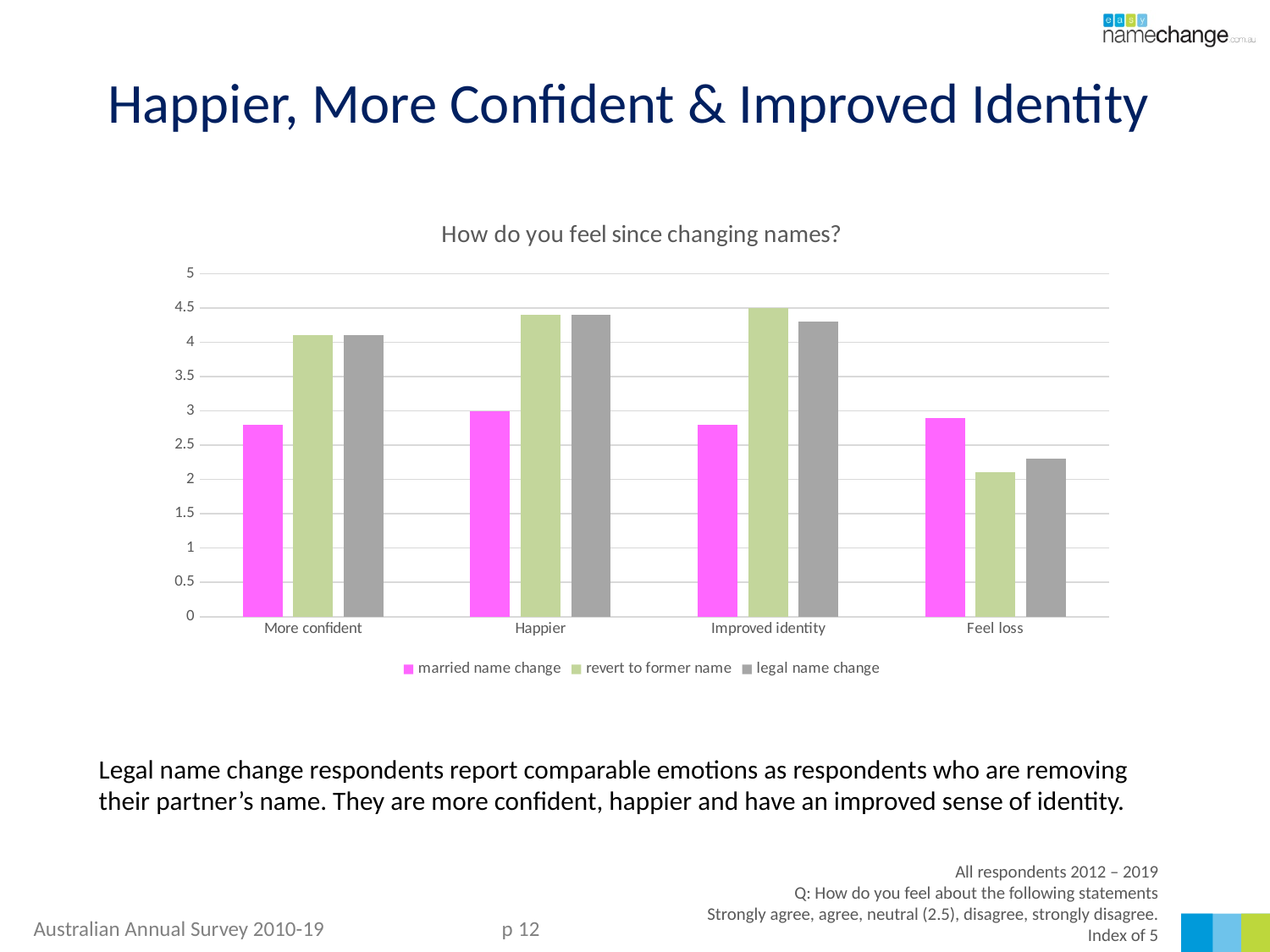
Which category has the highest value for revert to former name? Improved identity Is the value for married name change in the More confident category greater or less than 3? less Is the value for legal name change in the Feel loss category greater or less than 2.5? less Which series is shown in pink in the chart? married name change In the Feel loss category, which is larger: married name change or revert to former name? married name change What is the value for revert to former name in the Improved identity category? 4.5 What is the title of the chart? How do you feel since changing names? What type of chart is shown on the slide? bar chart How many categories are shown on the x axis of the chart? 4 Which category has the lowest value for legal name change? Feel loss What is the value for married name change in the Happier category? 3 How many series does the chart legend list? 3